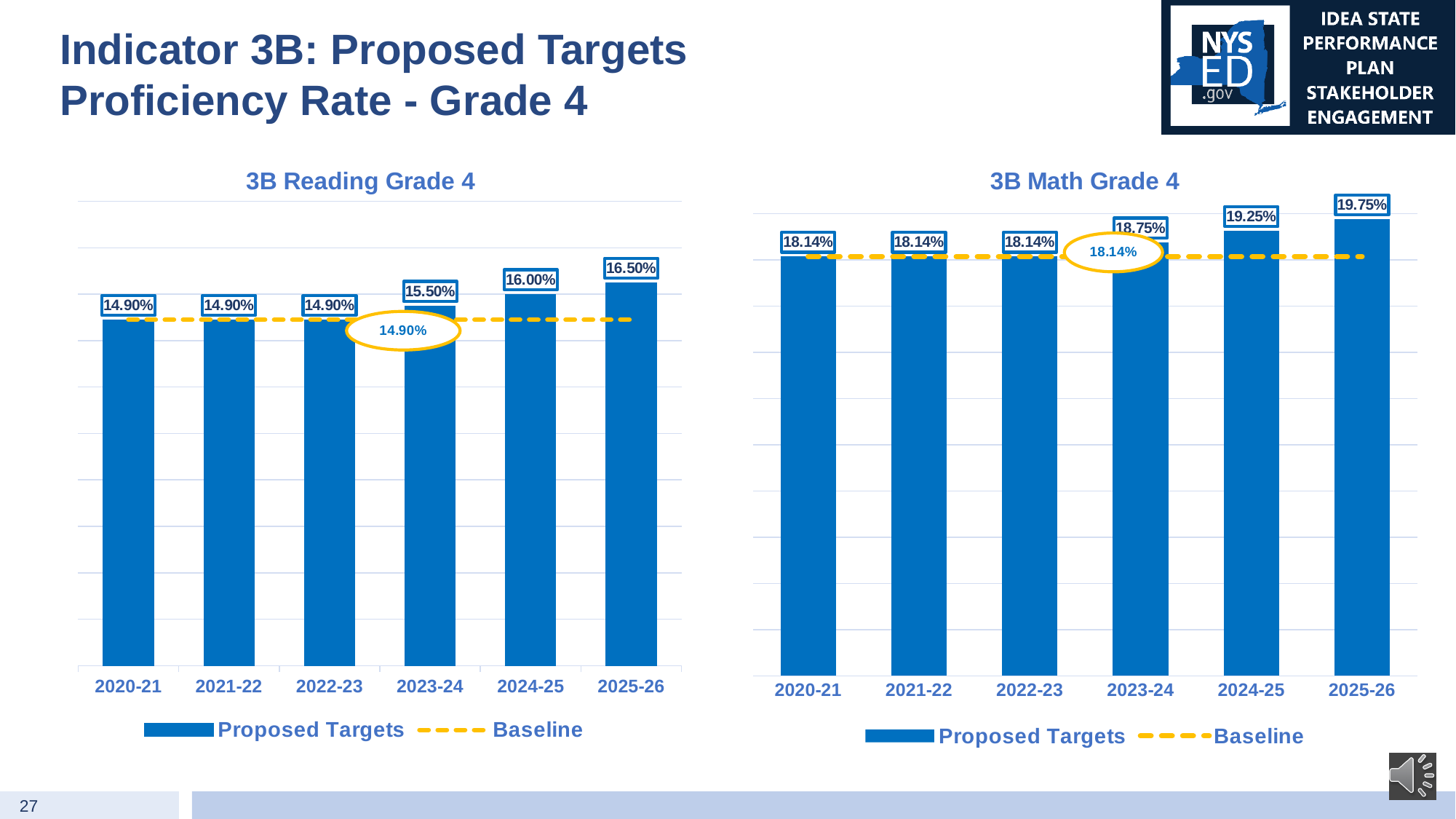
In the 3B Math Grade 4 chart, do the proposed targets rise or fall from 2022-23 to 2025-26? rise In the 3B Reading Grade 4 chart, is the proposed target for 2024-25 larger or smaller than the one for 2023-24? larger What kind of chart is the 3B Reading Grade 4 chart? combination bar and line chart In the 3B Reading Grade 4 chart, what is the baseline value shown? 14.90% In the 3B Reading Grade 4 chart, what is the proposed target for 2025-26? 16.50% How many years are shown on the x axis of the 3B Math Grade 4 chart? 6 In the 3B Math Grade 4 chart, what is the proposed target for 2023-24? 18.75% In the 3B Math Grade 4 chart, what is the baseline value shown? 18.14% In the 3B Math Grade 4 chart, which year has the highest proposed target? 2025-26 In the 3B Reading Grade 4 chart, what is the difference between the proposed targets for 2025-26 and 2020-21? 1.60% How many entries does the legend of the 3B Reading Grade 4 chart list? 2 In the 3B Math Grade 4 chart, what is the difference between the proposed targets for 2025-26 and 2024-25? 0.50%